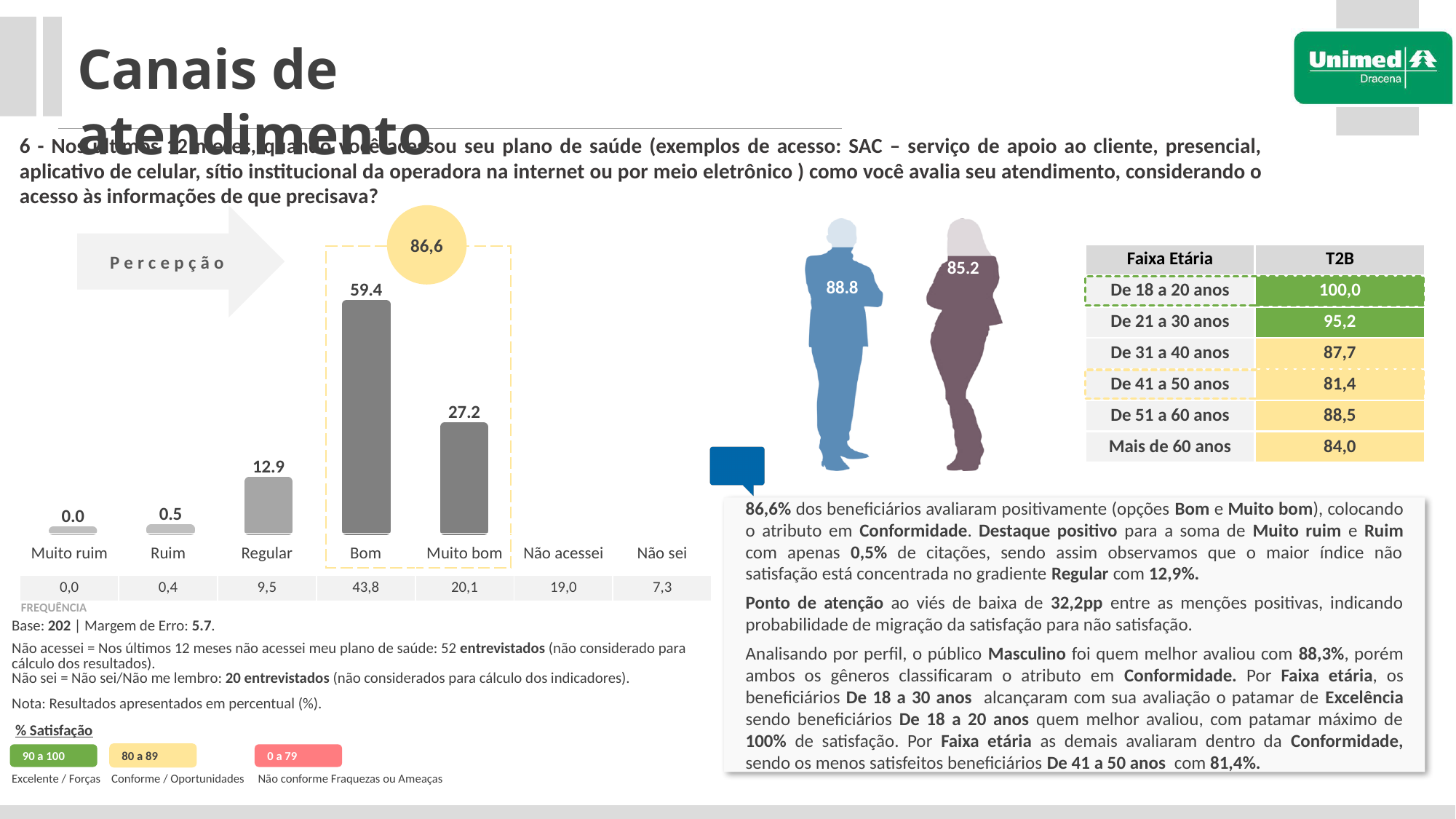
In the Faixa Etária table, what is the T2B value for 'De 41 a 50 anos'? 81,4 What is the value shown for the 'Muito bom' bar in the bar chart? 27.2 What is the combined value of 'Bom' and 'Muito bom' shown in the yellow circle above the bar chart? 86,6 What is the value shown for the 'Regular' bar in the bar chart? 12.9 In the Faixa Etária table, which age group has the highest T2B value? De 18 a 20 anos Which category has the highest bar in the bar chart? Bom What is the difference between the 'Bom' and 'Muito bom' values in the bar chart? 32.2 Which category has the lowest value in the bar chart? Muito ruim In the bar chart, which is larger: the value for 'Regular' or the value for 'Muito bom'? Muito bom What type of chart is used to show the Percepção results? bar chart What is the value shown for the 'Bom' bar in the bar chart? 59.4 How many bars with data labels are plotted in the bar chart? 5